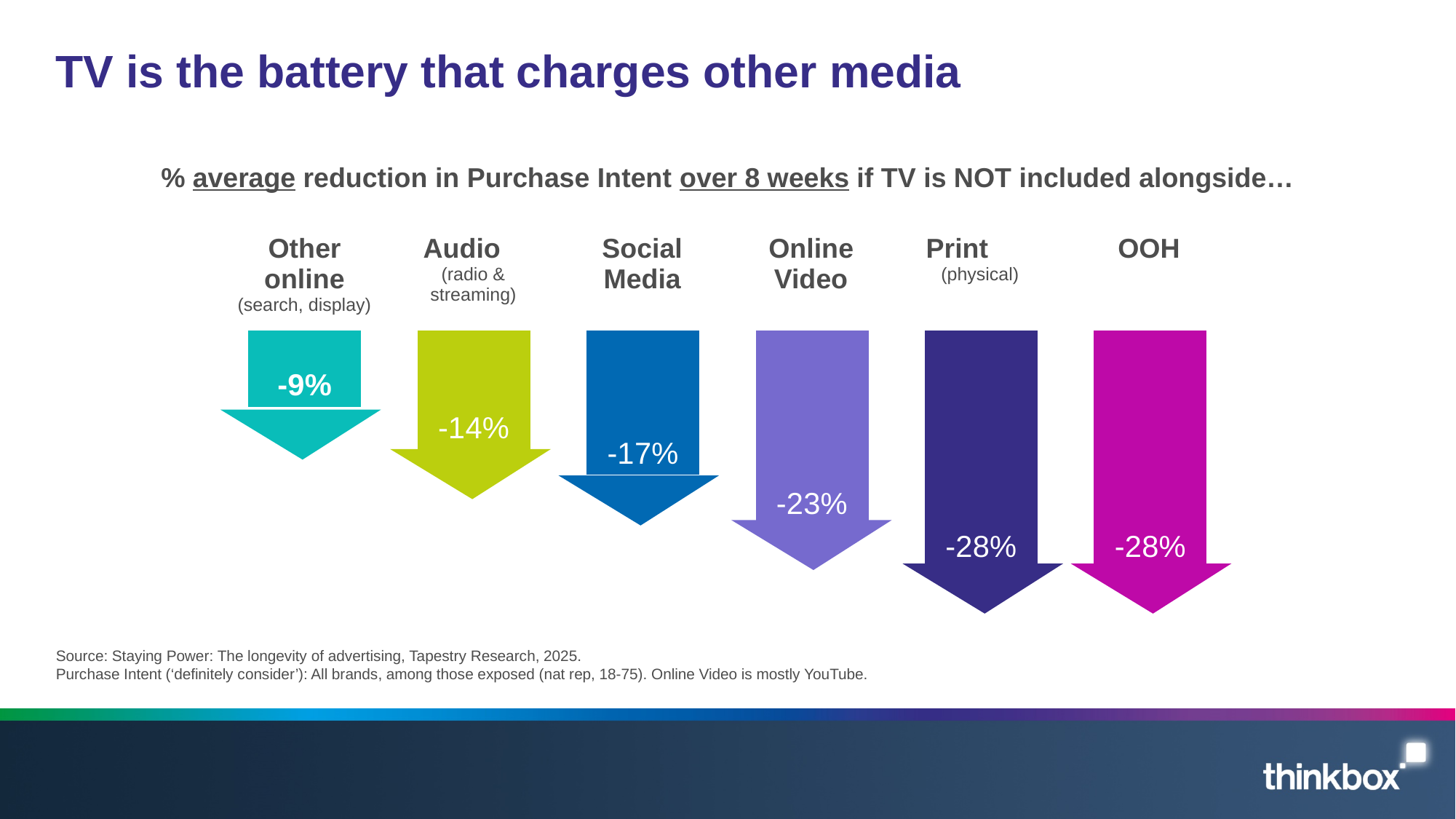
What is the value shown for Social Media? -17% Which shows a larger reduction, Social Media or Audio? Social Media Do the reductions get larger or smaller moving from left to right across the chart? Larger What is the difference between the values for Audio and Other online? 5 percentage points What is the value shown for Print (physical)? -28% Which category shows the smallest reduction in Purchase Intent? Other online (search, display) What is the difference between the values for Online Video and Social Media? 6 percentage points What is the value shown for Other online (search, display)? -9% How many media categories are shown in the chart? 6 What is the value shown for Online Video? -23% What is the title of the slide? TV is the battery that charges other media What is the value shown for Audio (radio & streaming)? -14%